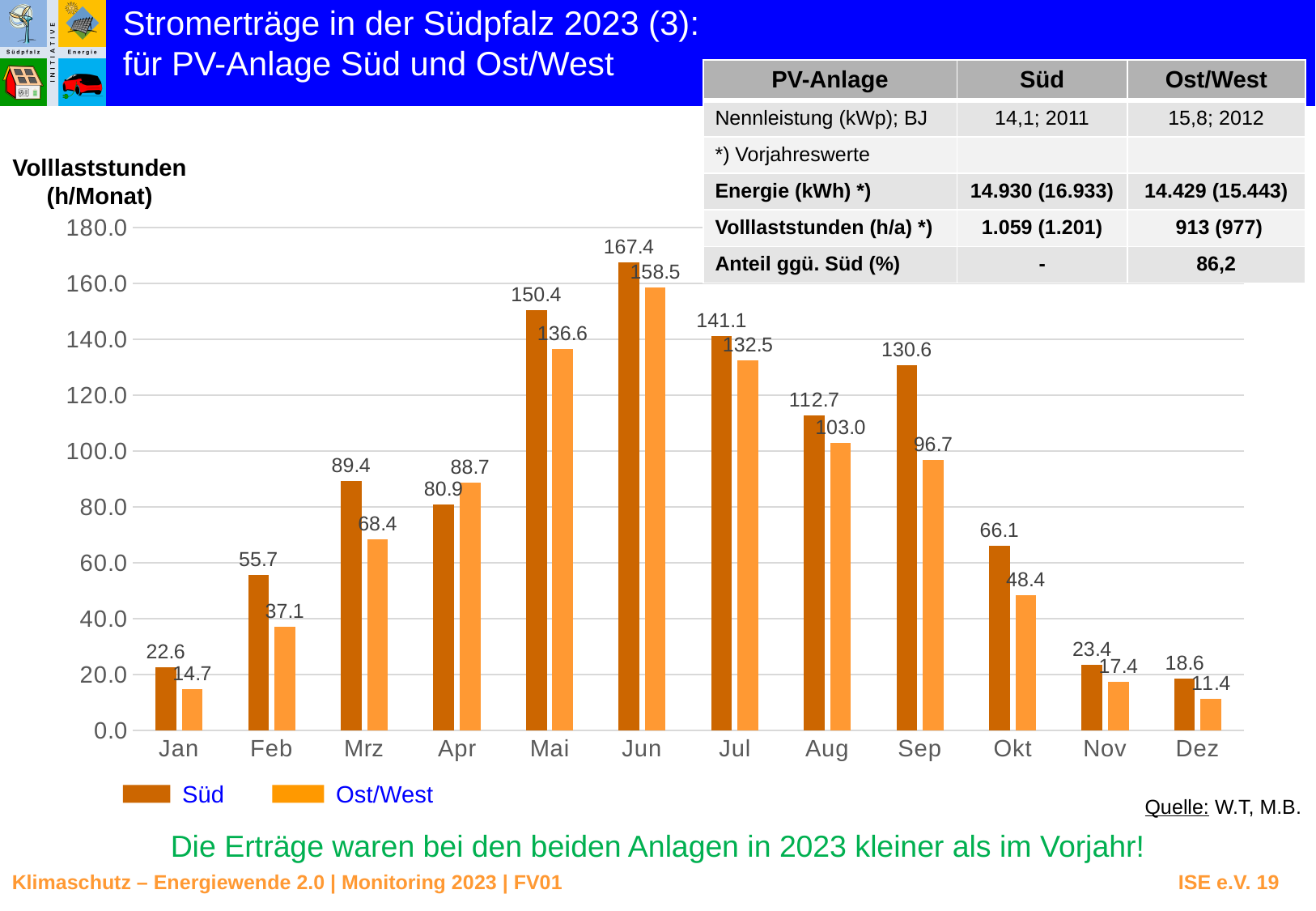
What is the Süd value for Sep? 130.6 What is the difference between the Süd and Ost/West values for Mai? 13.8 What is the Süd value for Jun? 167.4 What is the Ost/West value for Apr? 88.7 What kind of chart is shown? bar chart How many months are shown on the x axis? 12 Is the Süd value for Aug greater or less than 100.0? greater Which month has the lowest Süd value? Dez Which month has the highest Ost/West value? Jun Which is larger in Apr, the Süd value or the Ost/West value? Ost/West How many series does the legend list? 2 What is the y-axis label of the chart? Volllaststunden (h/Monat)